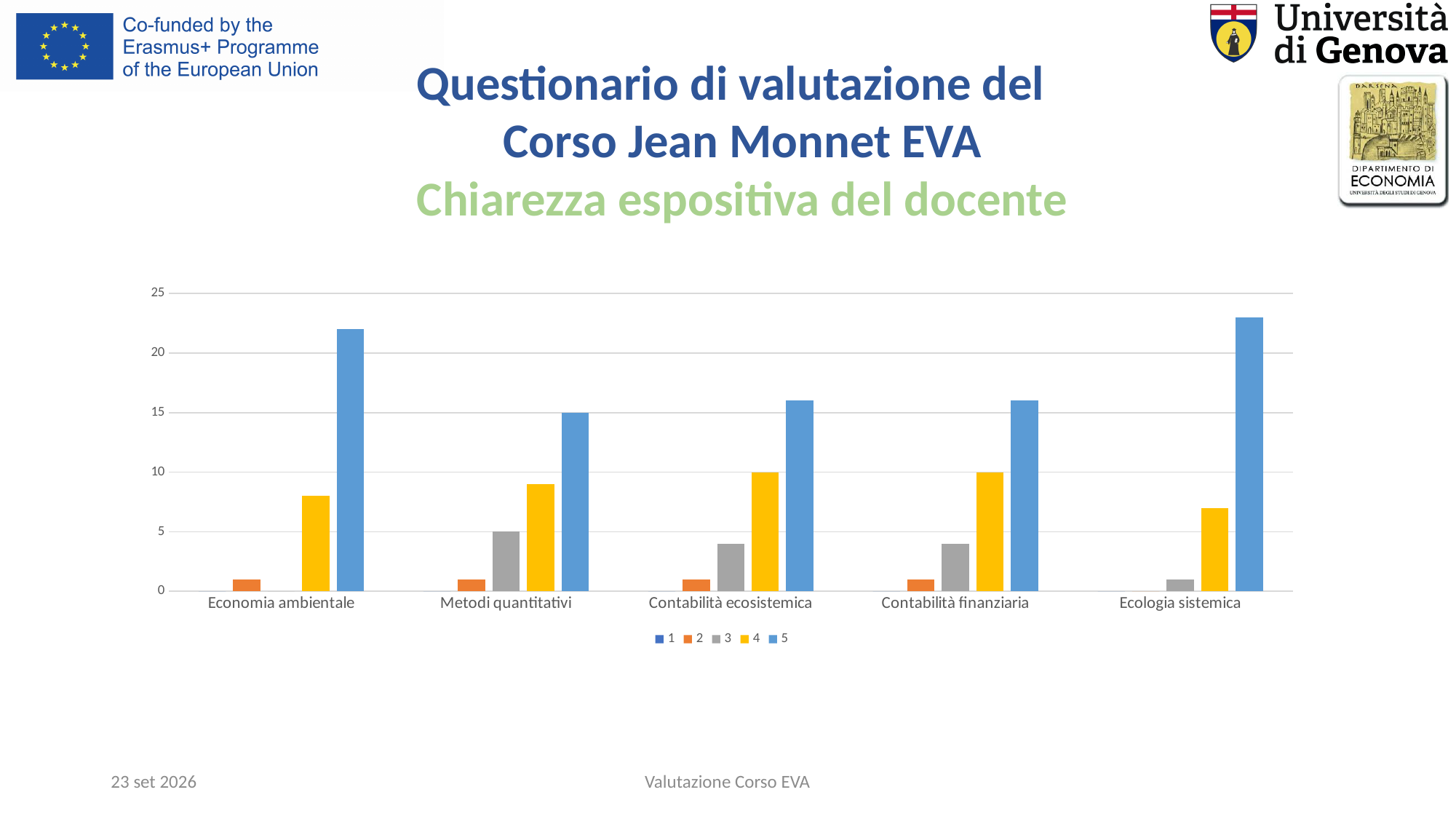
What is the green subtitle above the chart? Chiarezza espositiva del docente How many categories are shown on the x axis of the chart? 5 What is the value of series 4 for Contabilità ecosistemica? 10 Is the value of series 3 for Ecologia sistemica greater or less than 5? less What is the value of series 3 for Metodi quantitativi? 5 What is the value of series 5 for Metodi quantitativi? 15 What kind of chart is shown on the slide? bar chart For Economia ambientale, which is larger: series 4 or series 5? series 5 Is the value of series 4 for Economia ambientale greater or less than 10? less Which series has the highest value for Contabilità finanziaria? 5 Is the value of series 5 for Economia ambientale greater or less than 20? greater How many series does the chart legend list? 5